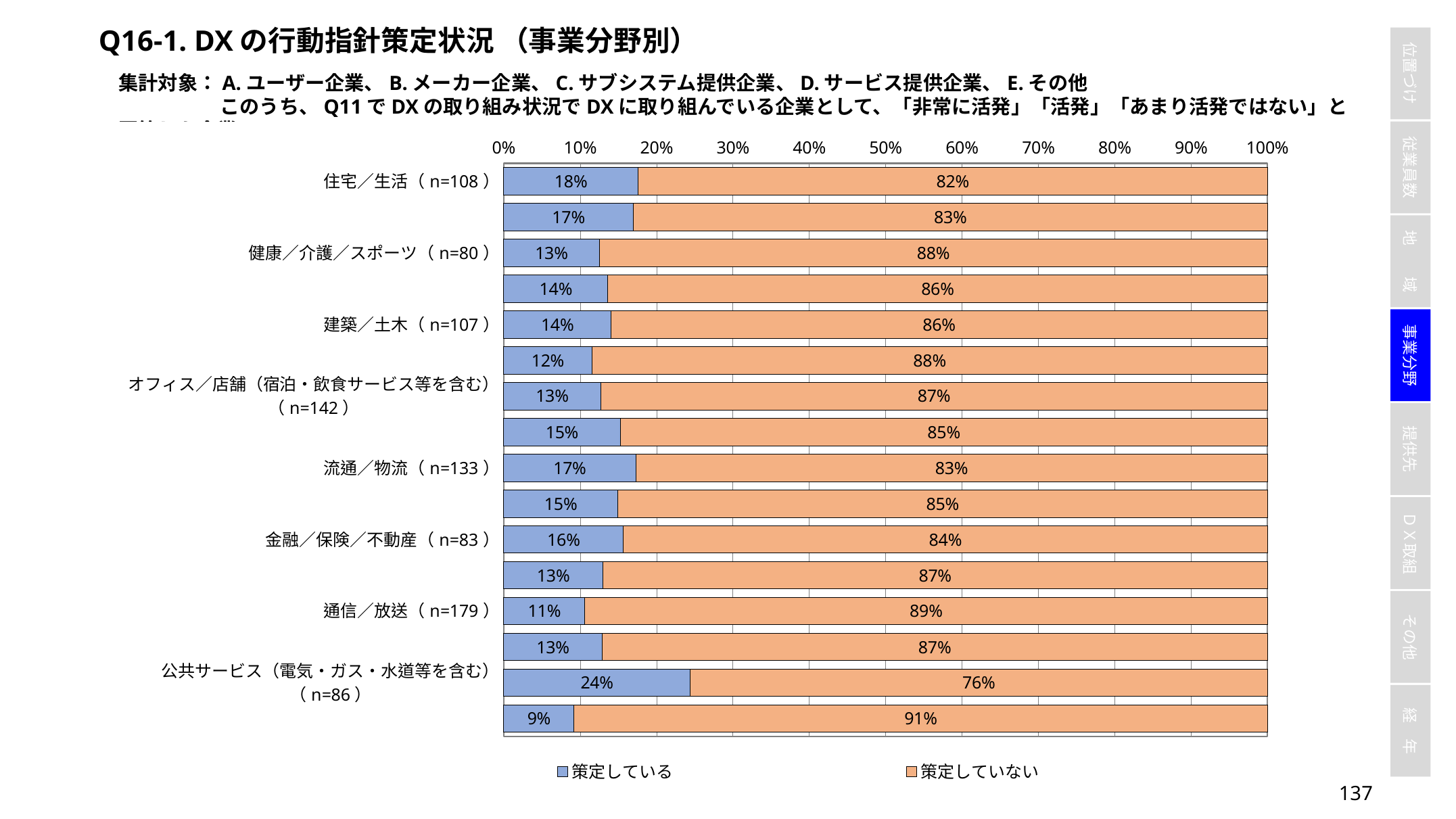
What is the difference between the 策定している values for 公共サービス (n=86) and 通信／放送 (n=179)? 13% Which has a larger 策定している share: 住宅／生活 (n=108) or 建築／土木 (n=107)? 住宅／生活 What percentage of 住宅／生活 (n=108) companies answered 策定している? 18% What is the 策定していない value for 通信／放送 (n=179)? 89% What percentage of 金融／保険／不動産 (n=83) companies answered 策定していない? 84% Which legend entry is shown in orange? 策定していない Which labeled category has the highest 策定している share? 公共サービス（電気・ガス・水道等を含む） What is the total of the stacked bar for 健康／介護／スポーツ (n=80)? 101% What is the 策定している value for 公共サービス（電気・ガス・水道等を含む）(n=86)? 24% How many series does the legend list? 2 Is the 策定していない value for 流通／物流 (n=133) greater or less than 80%? greater What kind of chart is shown on the slide? Stacked bar chart